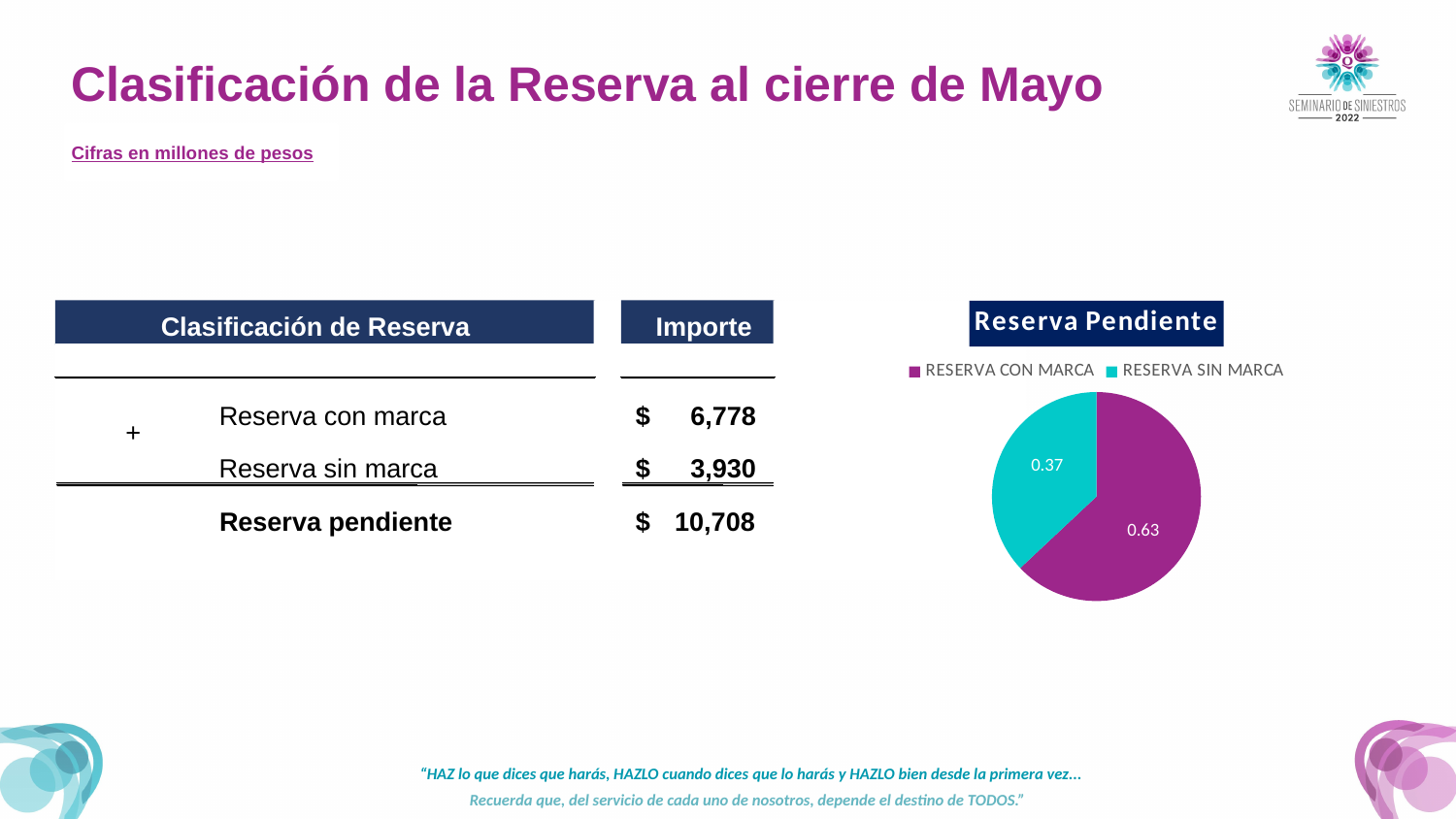
What share of the pie does RESERVA SIN MARCA represent? 0.37 What value is shown for RESERVA SIN MARCA in the pie chart? 0.37 What type of chart is shown on the slide? pie chart What is the difference between the RESERVA CON MARCA and RESERVA SIN MARCA values in the pie chart? 0.26 Which slice of the pie chart is the smallest? RESERVA SIN MARCA How many entries does the chart legend list? 2 How many slices does the pie chart have? 2 What is the title of the chart? Reserva Pendiente What value is shown for RESERVA CON MARCA in the pie chart? 0.63 Which slice of the pie chart is the largest? RESERVA CON MARCA Which is larger in the pie chart, RESERVA CON MARCA or RESERVA SIN MARCA? RESERVA CON MARCA What colour is the RESERVA SIN MARCA slice in the pie chart? teal